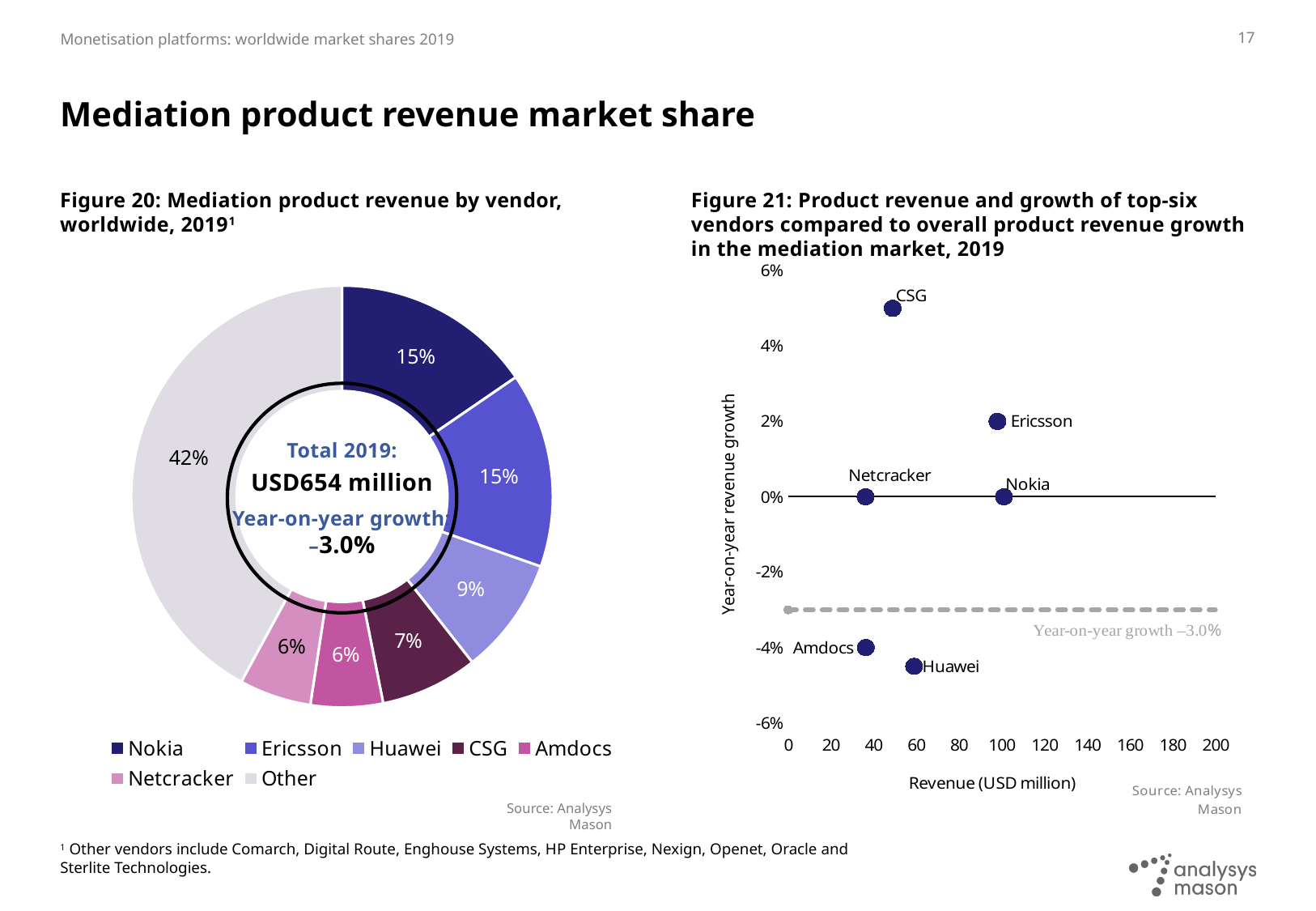
In Figure 20, what share of mediation product revenue does Nokia hold? 15% In Figure 20, what share does CSG hold? 7% In Figure 20, which segment is the largest? Other In Figure 20, what total 2019 revenue is shown in the centre of the chart? USD654 million In Figure 21, which vendor has the lowest year-on-year revenue growth? Huawei In Figure 21, which vendor has the highest year-on-year revenue growth? CSG In Figure 20, what share of mediation product revenue does Huawei hold? 9% In Figure 21, is the year-on-year revenue growth for CSG greater or less than 4%? greater In Figure 20, what is the difference between the Other share and the Nokia share? 27% In Figure 20, which has the larger share, Huawei or CSG? Huawei In Figure 20, how many segments does the chart have? 7 What kind of chart is Figure 20? Pie (donut) chart